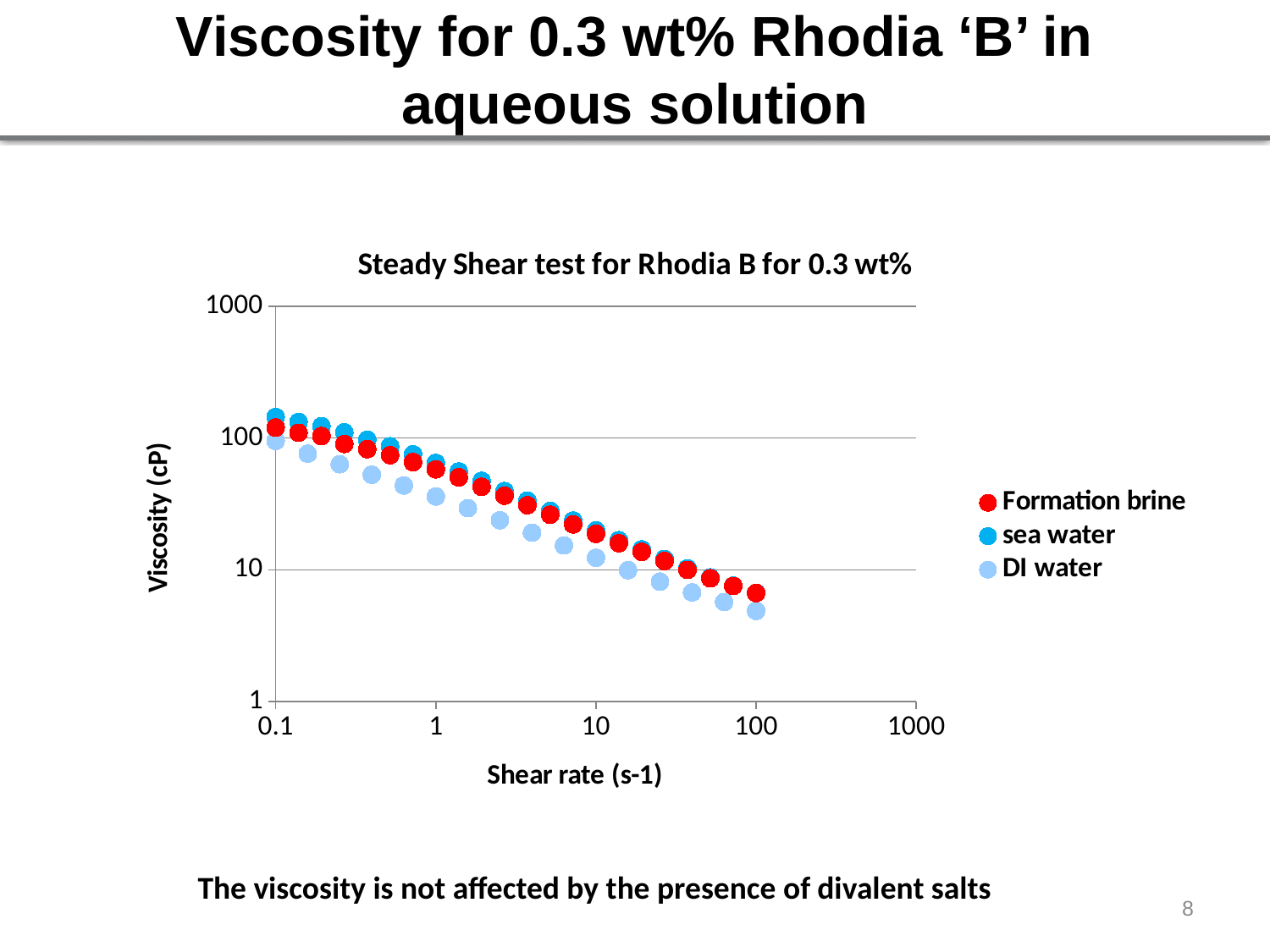
At a shear rate of 0.1, which series has the higher viscosity: sea water or DI water? sea water Is the viscosity for Formation brine at a shear rate of 100 greater or less than 10? less What is the label of the y axis? Viscosity (cP) Is the viscosity for sea water at a shear rate of 0.1 greater or less than 100? greater What kind of chart is shown on the slide? Scatter chart What is the title of the chart? Steady Shear test for Rhodia B for 0.3 wt% How many series does the legend list? 3 Do the viscosity values rise or fall as the shear rate increases along the x axis? Fall Is the viscosity for DI water at a shear rate of 100 greater or less than 10? less At a shear rate of 100, which series has the higher viscosity: Formation brine or DI water? Formation brine